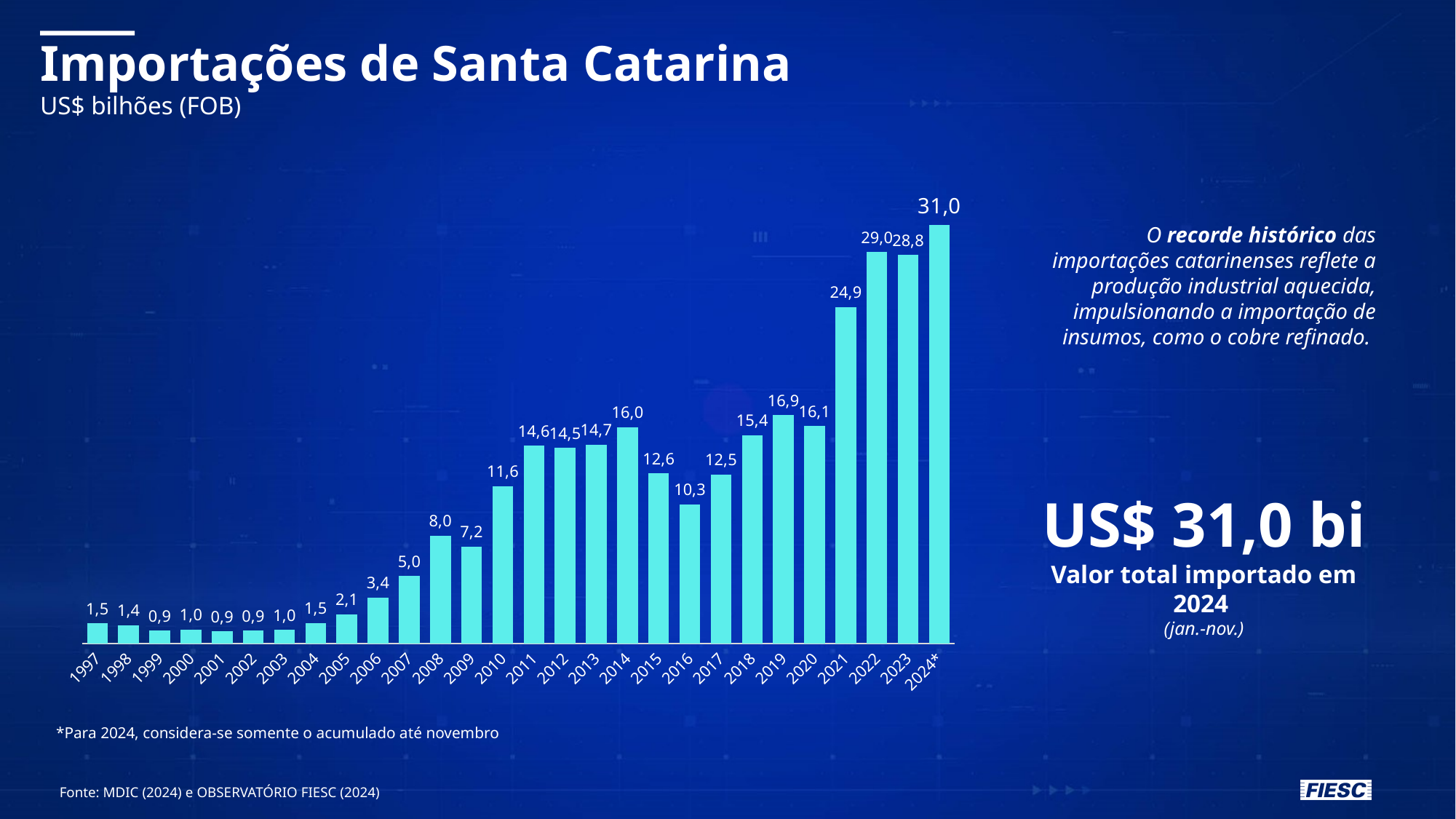
What kind of chart is shown? Bar chart Do the values generally rise or fall from 1997 to 2024*? Rise Which is larger, the value for 2022 or the value for 2023? 2022 What unit is stated under the chart title? US$ bilhões (FOB) What is the value for 2016? 10,3 What is the difference between the values for 2022 and 2021? 4,1 Which year has the highest value? 2024* Which is larger, the value for 2014 or the value for 2019? 2019 What is the value for 2021? 24,9 What is the difference between the values for 2024* and 2023? 2,2 How many years are shown on the x axis? 28 What is the value for 2008? 8,0